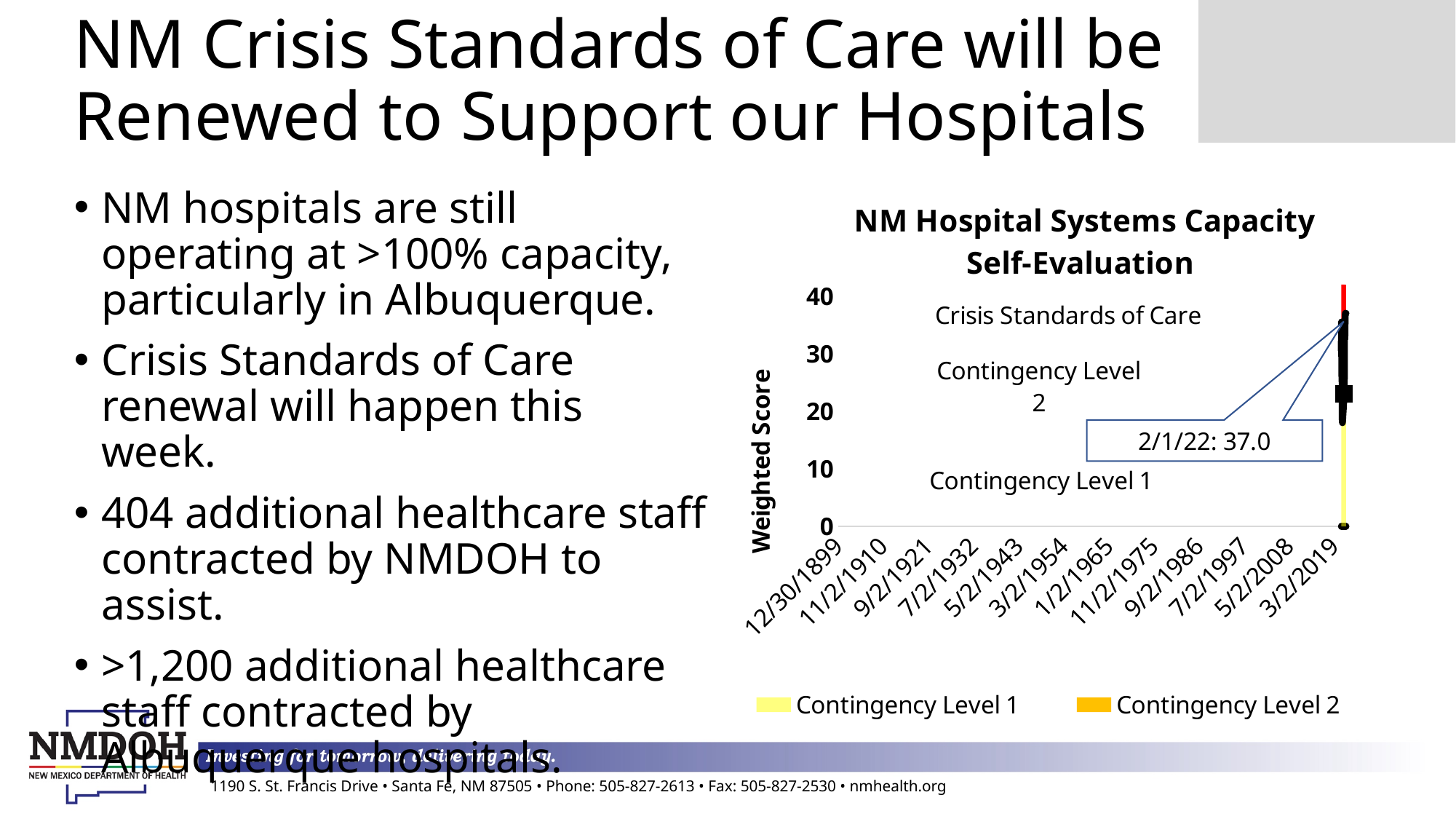
How many date labels are shown along the x-axis of the chart? 12 What is the highest tick value shown on the y-axis of the chart? 40 Is the labeled value for 2/1/22 greater or less than 30? greater How many series does the chart's legend list? 2 What is the title of the chart on the slide? NM Hospital Systems Capacity Self-Evaluation Is the labeled value for 2/1/22 greater or less than 40? less What are the two entries in the chart's legend? Contingency Level 1 and Contingency Level 2 What weighted score is shown in the data label for 2/1/22? 37.0